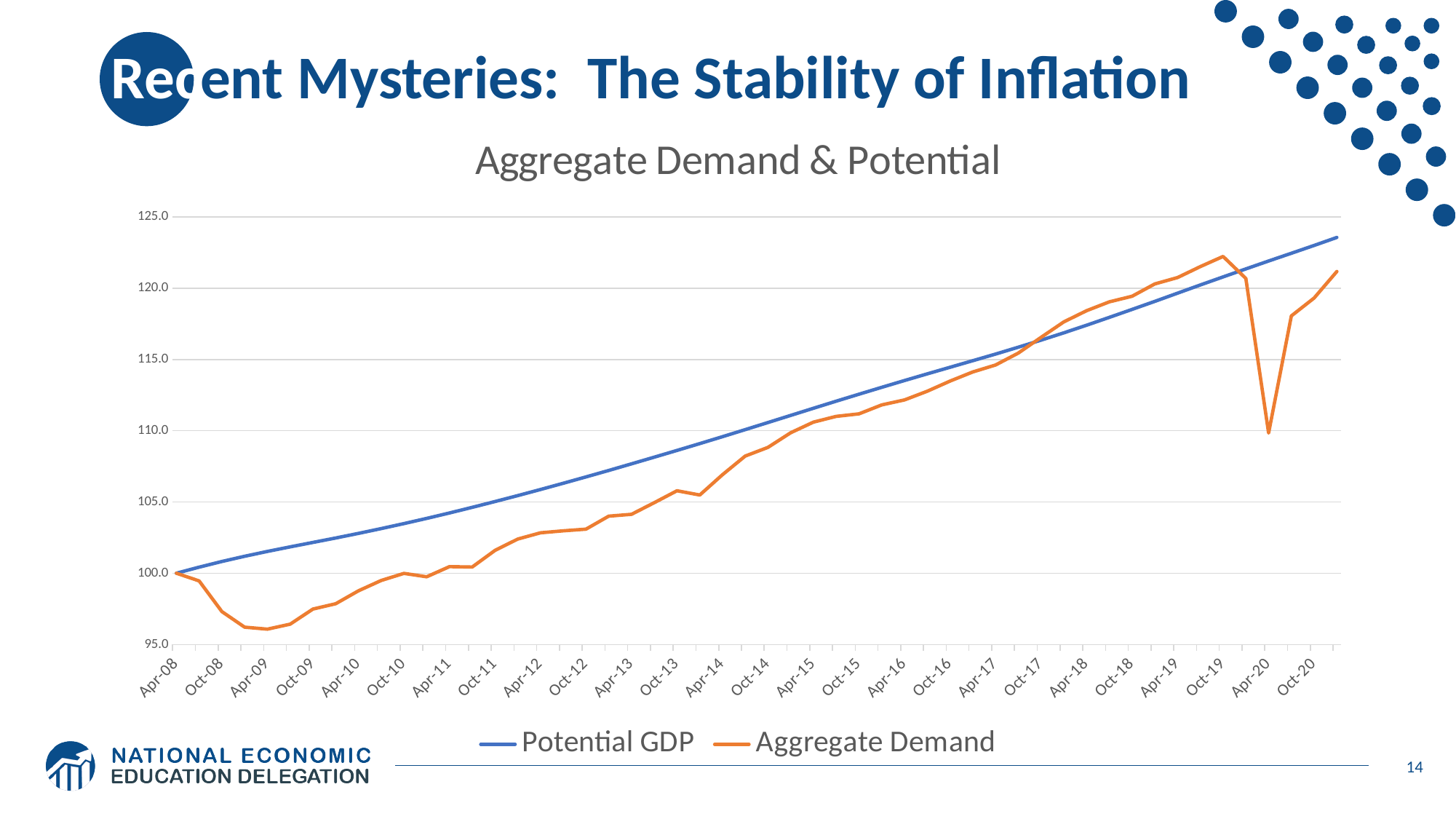
Does the Potential GDP line rise or fall from Apr-08 to Oct-20? Rise What kind of chart is shown on the slide? Line chart At Oct-19, which series has the higher value, Potential GDP or Aggregate Demand? Aggregate Demand Is the value of Potential GDP at Oct-20 greater or less than 120.0? greater How many series does the legend list? 2 How many date labels are shown on the x axis? 26 At Apr-09, which series has the higher value, Potential GDP or Aggregate Demand? Potential GDP Is the value of Aggregate Demand at Apr-20 greater or less than 115.0? less What value do both Potential GDP and Aggregate Demand start at in Apr-08? 100.0 What is the title of the chart? Aggregate Demand & Potential Which colour is used for the Aggregate Demand line? Orange Is the value of Aggregate Demand at Apr-09 greater or less than 100.0? less